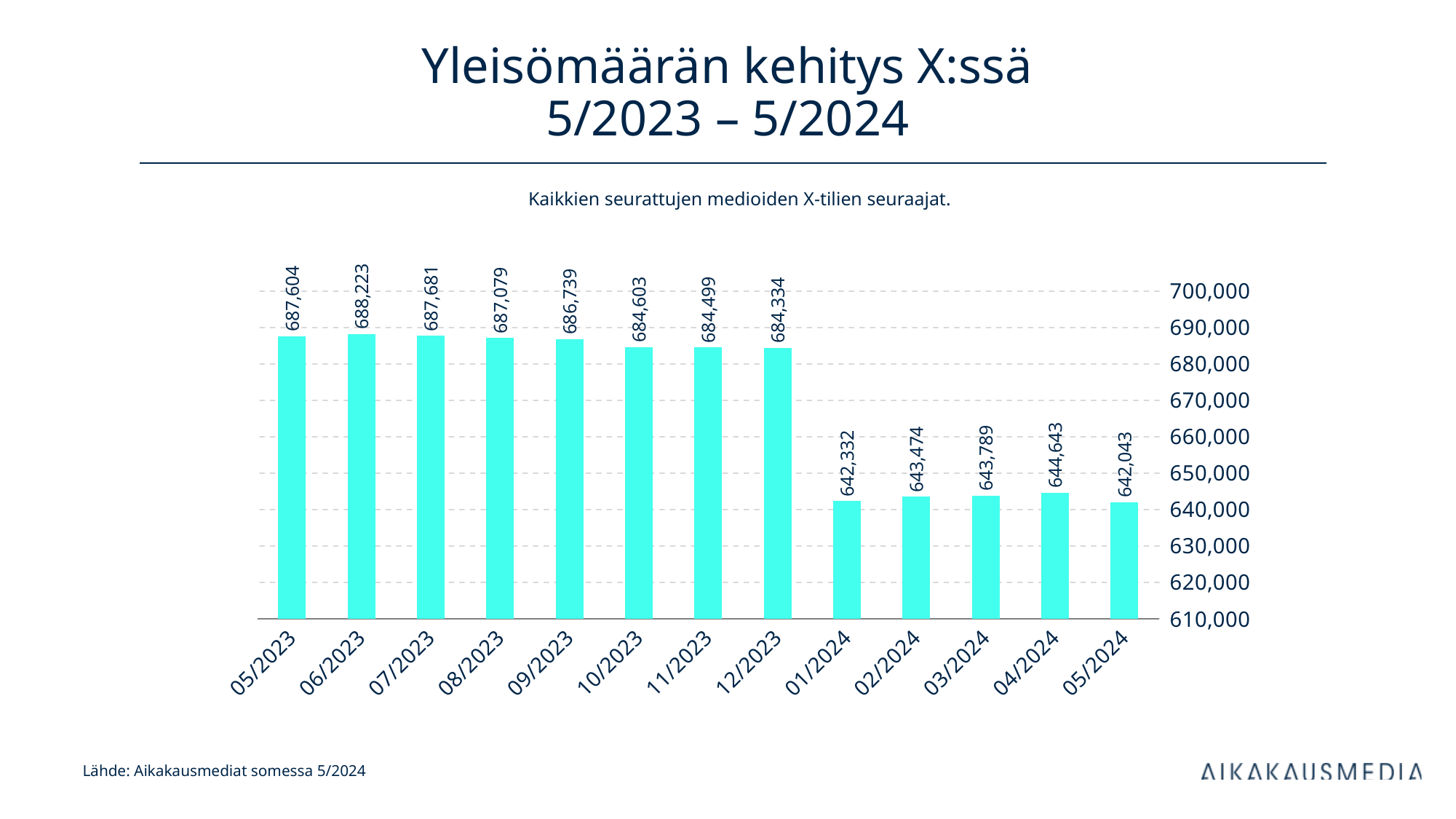
What is the value for 05/2023? 687,604 How many months are shown on the x axis? 13 Which month has the highest value? 06/2023 What is the difference between the values for 12/2023 and 01/2024? 42,002 What kind of chart is shown on the slide? bar chart Which month has the lowest value? 05/2024 Is the value for 03/2024 greater or less than 650,000? less What is the difference between the values for 05/2023 and 05/2024? 45,561 What is the value for 05/2024? 642,043 Do the values generally rise or fall from 05/2023 to 05/2024? fall What is the value for 01/2024? 642,332 Which is larger, the value for 08/2023 or the value for 04/2024? 08/2023